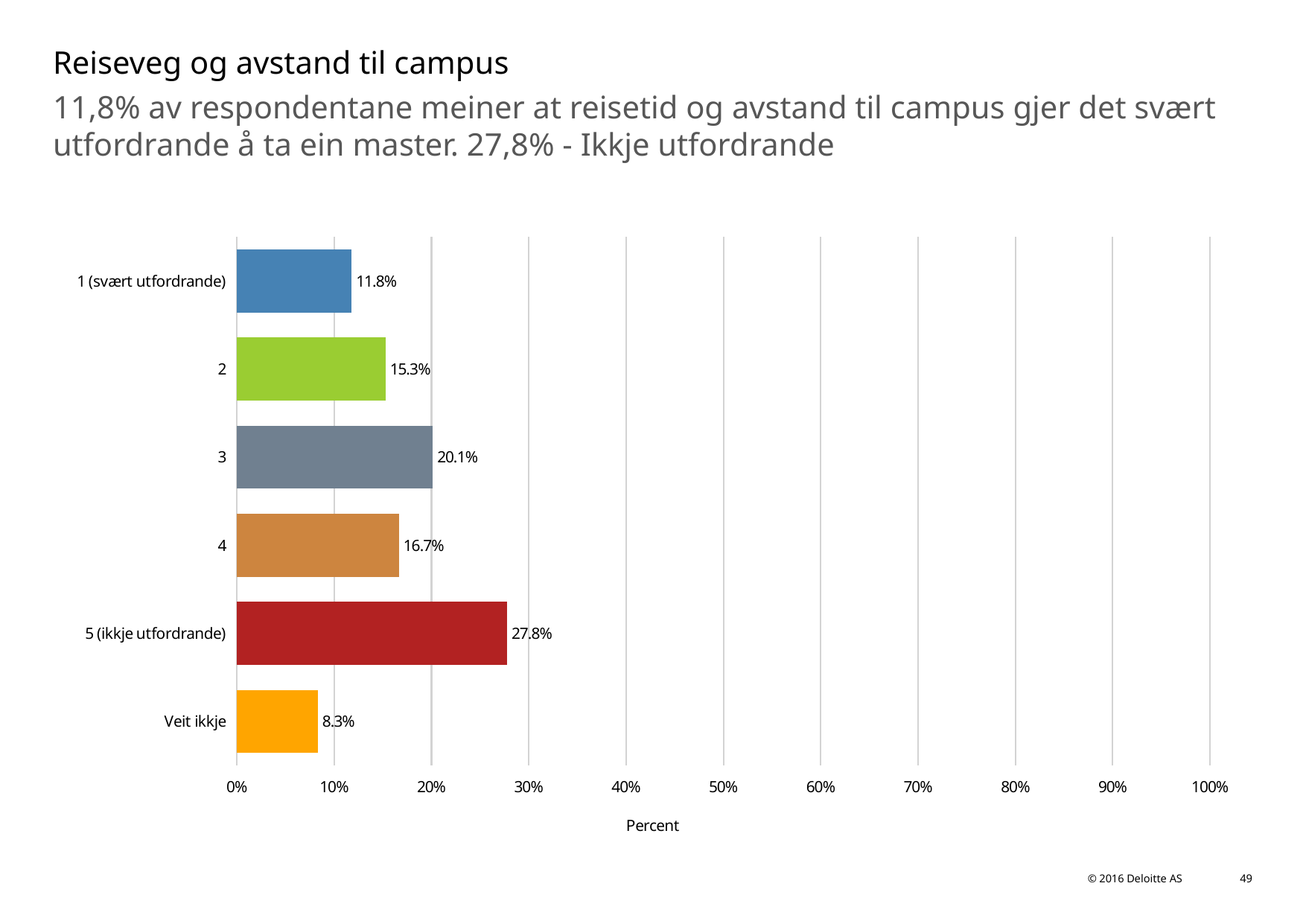
What is the value for "5 (ikkje utfordrande)"? 27.8% What kind of chart is shown on the slide? Bar chart Which category has the highest value? 5 (ikkje utfordrande) What is the difference between the values for "5 (ikkje utfordrande)" and "1 (svært utfordrande)"? 16.0% Which category has the lowest value? Veit ikkje Which is larger, the value for category "2" or category "4"? 4 What is the value for category "3"? 20.1% How many categories are shown in the chart? 6 What is the value for "1 (svært utfordrande)"? 11.8% What is the value for "Veit ikkje"? 8.3% What is the label of the horizontal axis? Percent Is the value for category "3" greater or less than 30%? less